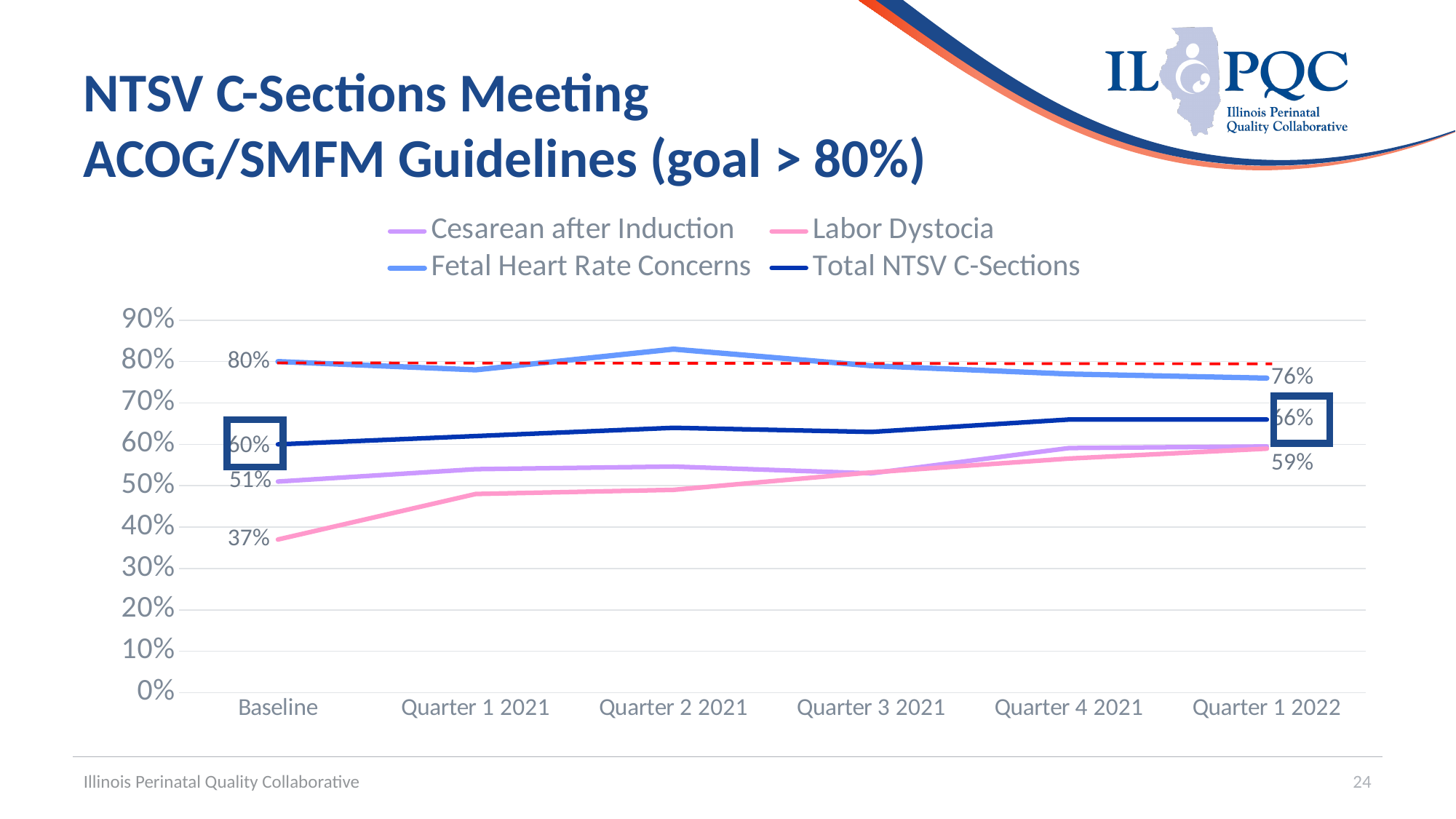
Does the Labor Dystocia line rise or fall from Baseline to Quarter 1 2022? Rise What is the value for Cesarean after Induction at Baseline? 51% How many series does the legend list? 4 What is the value for Total NTSV C-Sections at Quarter 1 2022? 66% At Baseline, which is larger: Cesarean after Induction or Labor Dystocia? Cesarean after Induction What type of chart is shown on the slide? Line chart Is the value for Fetal Heart Rate Concerns at Quarter 2 2021 greater or less than 80%? greater What is the value for Fetal Heart Rate Concerns at Baseline? 80% What is the value for Labor Dystocia at Baseline? 37% How many time points are plotted along the x axis? 6 Which series has the lowest value at Baseline? Labor Dystocia By how many percentage points did Total NTSV C-Sections change from Baseline (60%) to Quarter 1 2022 (66%)? 6 percentage points